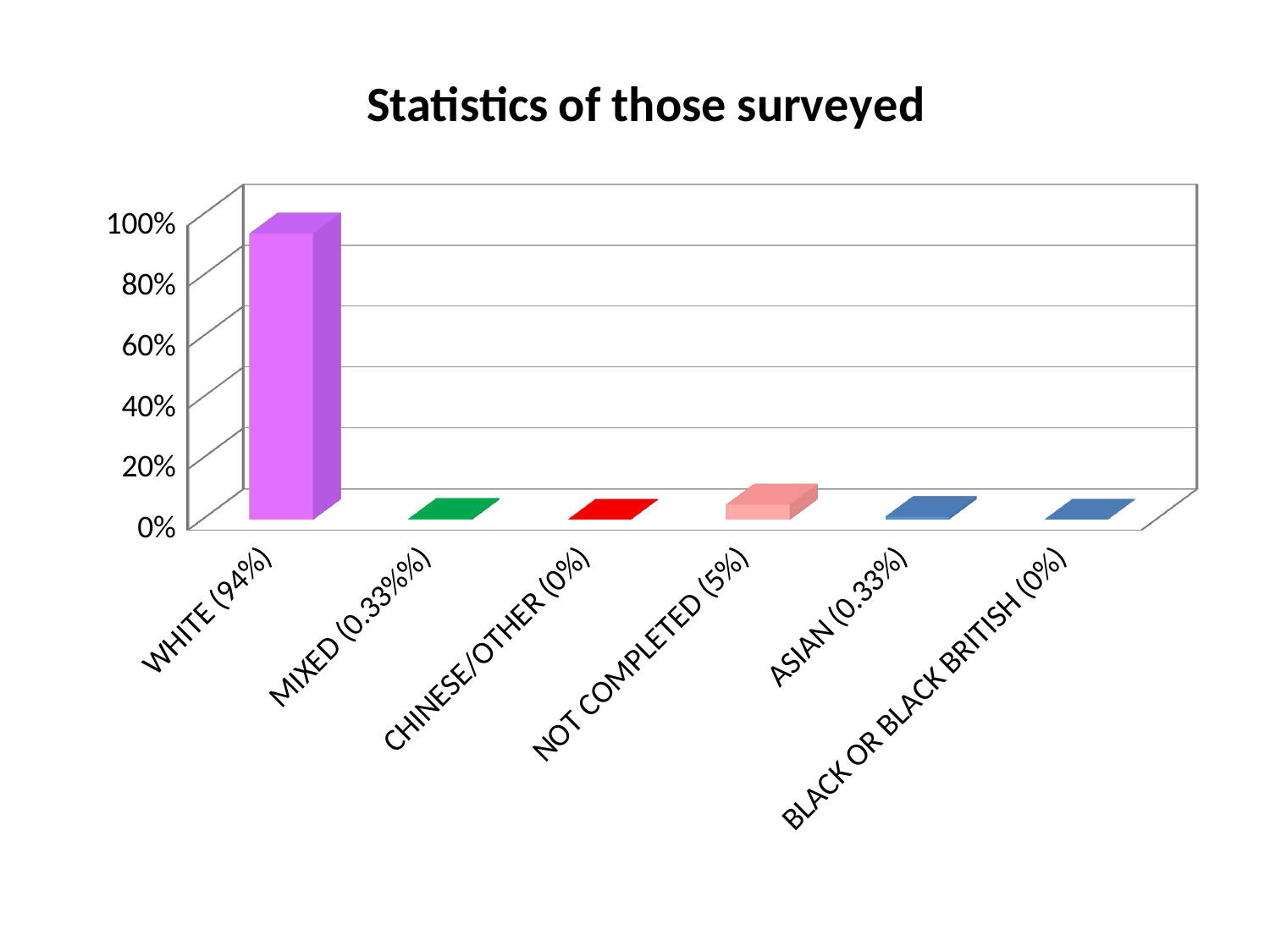
What is the title of the chart? Statistics of those surveyed Which category has the highest value? WHITE Is the value for NOT COMPLETED greater or less than 20%? less What percentage is shown for WHITE in the category label? 94% What is the difference between the value for WHITE and the value for NOT COMPLETED? 89% What percentage is shown for ASIAN in the category label? 0.33% How many categories are shown on the x axis of the chart? 6 What percentage is shown for CHINESE/OTHER in the category label? 0% Is the value for WHITE greater or less than 80%? greater What percentage is shown for NOT COMPLETED in the category label? 5% Which is larger, the value for WHITE or the value for NOT COMPLETED? WHITE What kind of chart is shown on the slide? bar chart